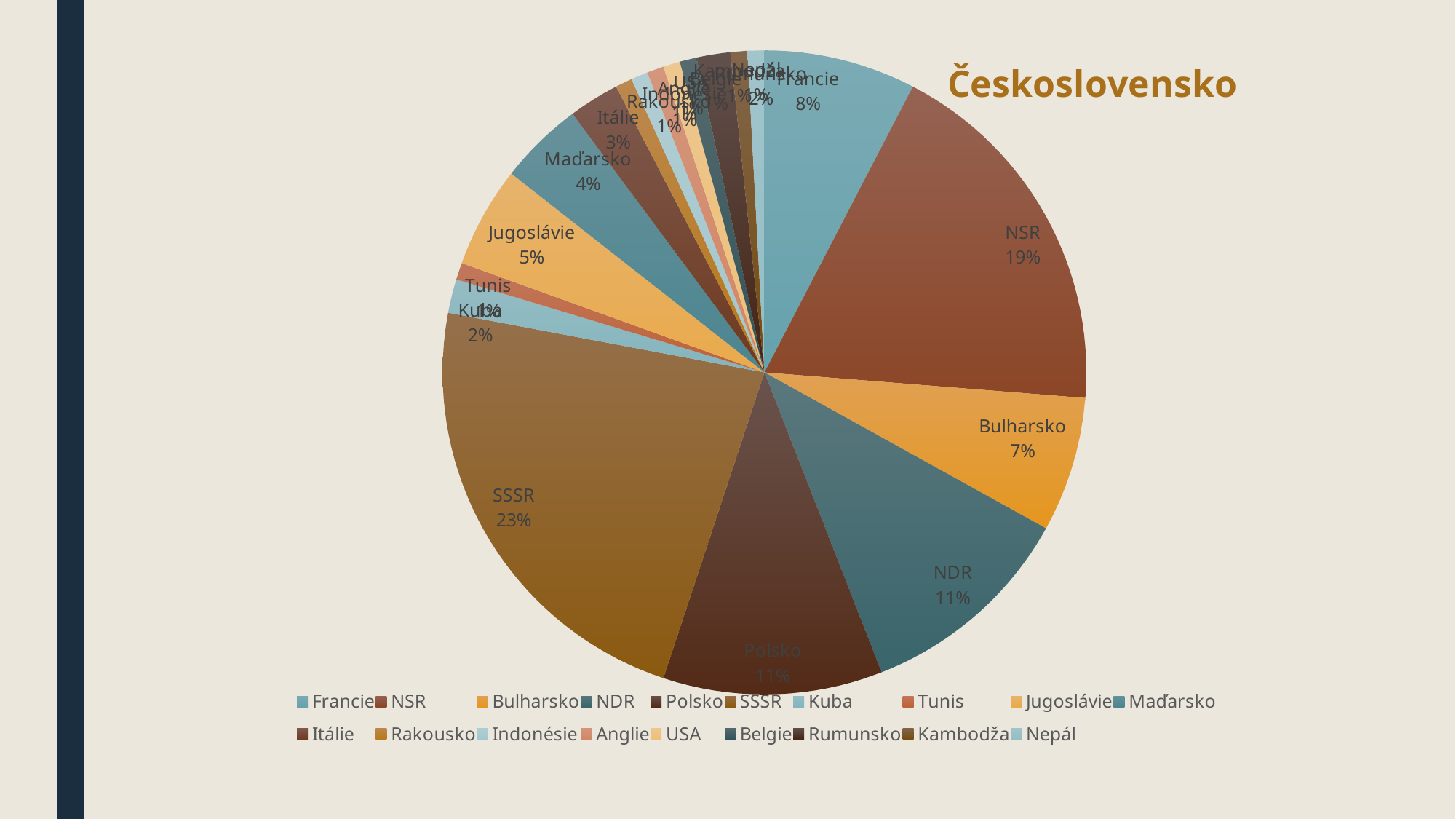
What percentage is shown for Bulharsko? 7% What kind of chart is shown on the slide? pie chart Which category has the largest slice of the pie? SSSR What percentage is shown for Francie? 8% How many categories does the legend list? 19 What percentage is shown for Maďarsko? 4% What is the title of the chart? Československo What percentage is shown for NSR? 19% What percentage is shown for Jugoslávie? 5% What is the difference in percentage points between SSSR and NSR? 4 What share of the pie does SSSR have? 23% Which has a larger share, NSR or NDR? NSR